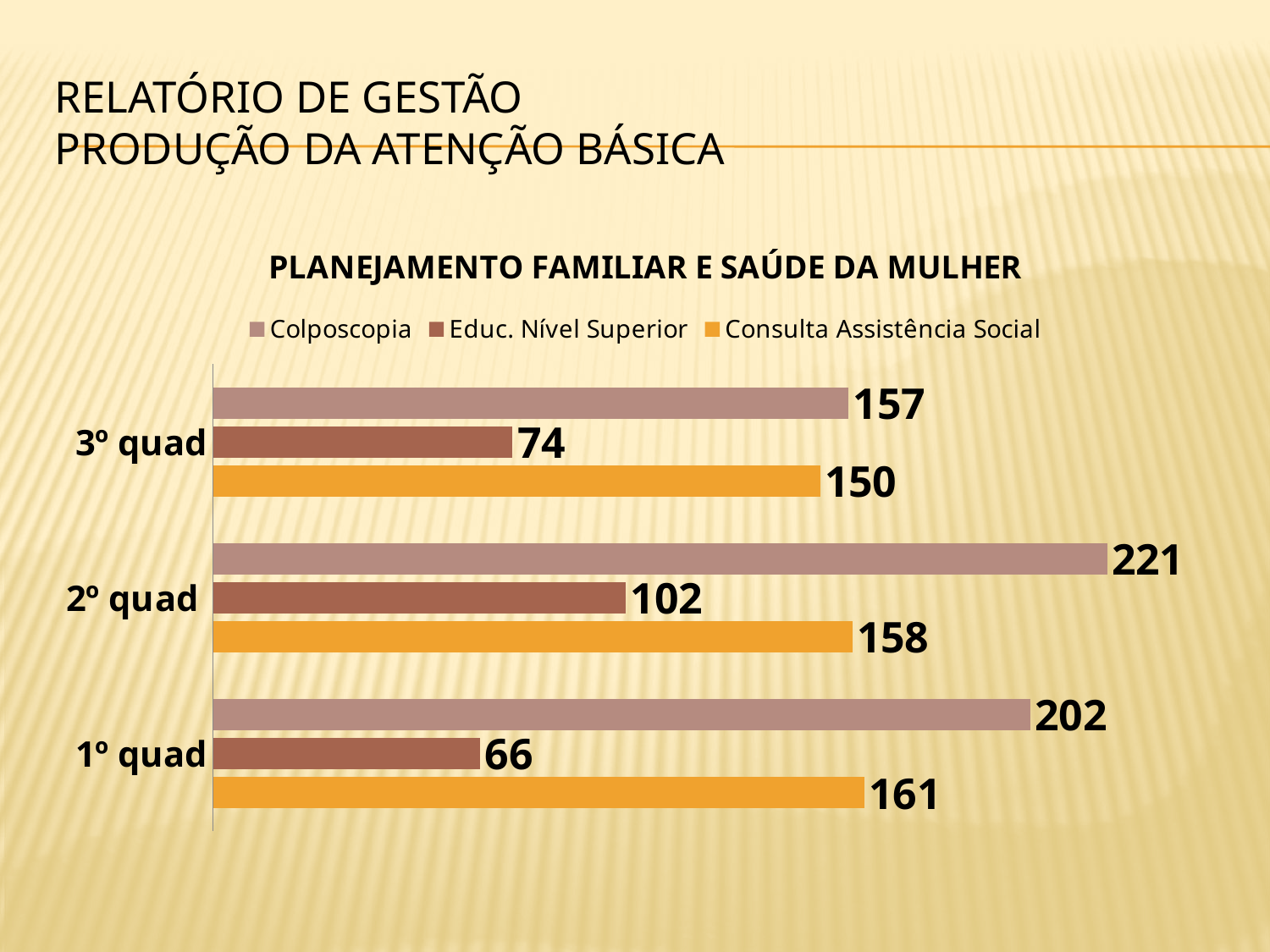
What is the difference between the Colposcopia values for 2º quad and 1º quad? 19 What is the value of Educ. Nível Superior for 1º quad? 66 Which quadrimester has the lowest Educ. Nível Superior value? 1º quad What kind of chart is shown on the slide? Bar chart How many quadrimester categories are shown on the chart? 3 What is the value of Consulta Assistência Social for 3º quad? 150 Which is larger in 2º quad: Colposcopia or Consulta Assistência Social? Colposcopia What is the difference between Consulta Assistência Social and Educ. Nível Superior in 3º quad? 76 What is the title of the chart? PLANEJAMENTO FAMILIAR E SAÚDE DA MULHER What is the value of Colposcopia for 2º quad? 221 How many series does the legend list? 3 Which quadrimester has the highest Colposcopia value? 2º quad